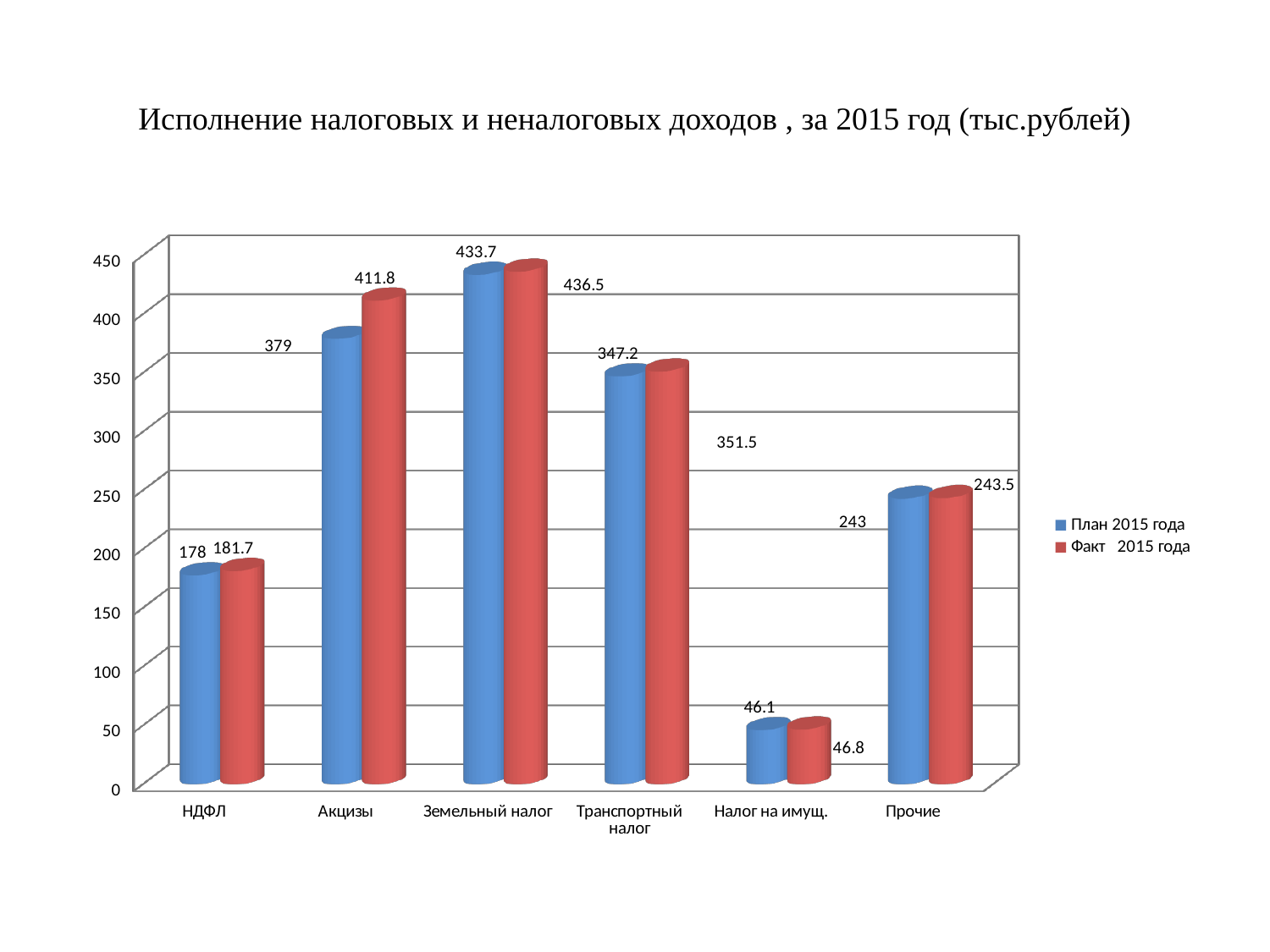
What is the Факт 2015 года value for Транспортный налог? 351.5 Which category has the highest План 2015 года value? Земельный налог What is the План 2015 года value for НДФЛ? 178 How many categories are shown on the x axis? 6 What is the Факт 2015 года value for Прочие? 243.5 What is the План 2015 года value for Акцизы? 379 What is the difference between the Факт 2015 года and План 2015 года values for Акцизы? 32.8 How many series does the legend list? 2 What is the Факт 2015 года value for Акцизы? 411.8 Which category has the lowest Факт 2015 года value? Налог на имущ. Which is larger for НДФЛ: the План 2015 года value or the Факт 2015 года value? Факт 2015 года What kind of chart is shown on the slide? Bar chart